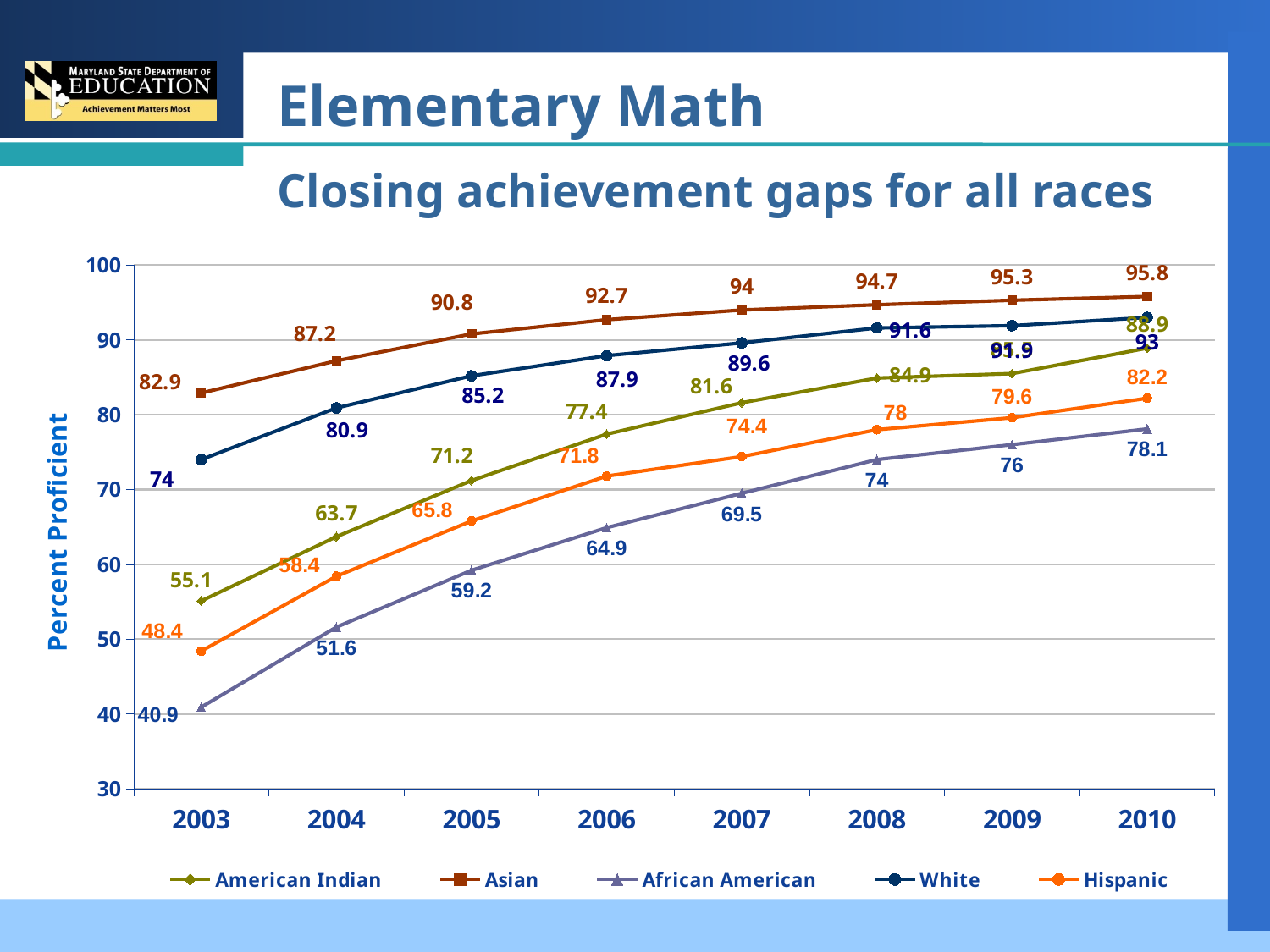
Does the African American line rise or fall from 2003 to 2010? Rise How many series does the legend list? 5 Which group has the lowest value in 2003? African American What is the difference between the Asian and African American values in 2010? 17.7 What is the difference between the Asian and African American values in 2003? 42 What is the value for African American in 2010? 78.1 What kind of chart is shown on the slide? Line chart Which is larger in 2005, the value for White or the value for American Indian? White How many years are plotted along the x axis? 8 What is the value for Hispanic in 2006? 71.8 Which group has the highest value in 2010? Asian What is the value for Asian in 2003? 82.9